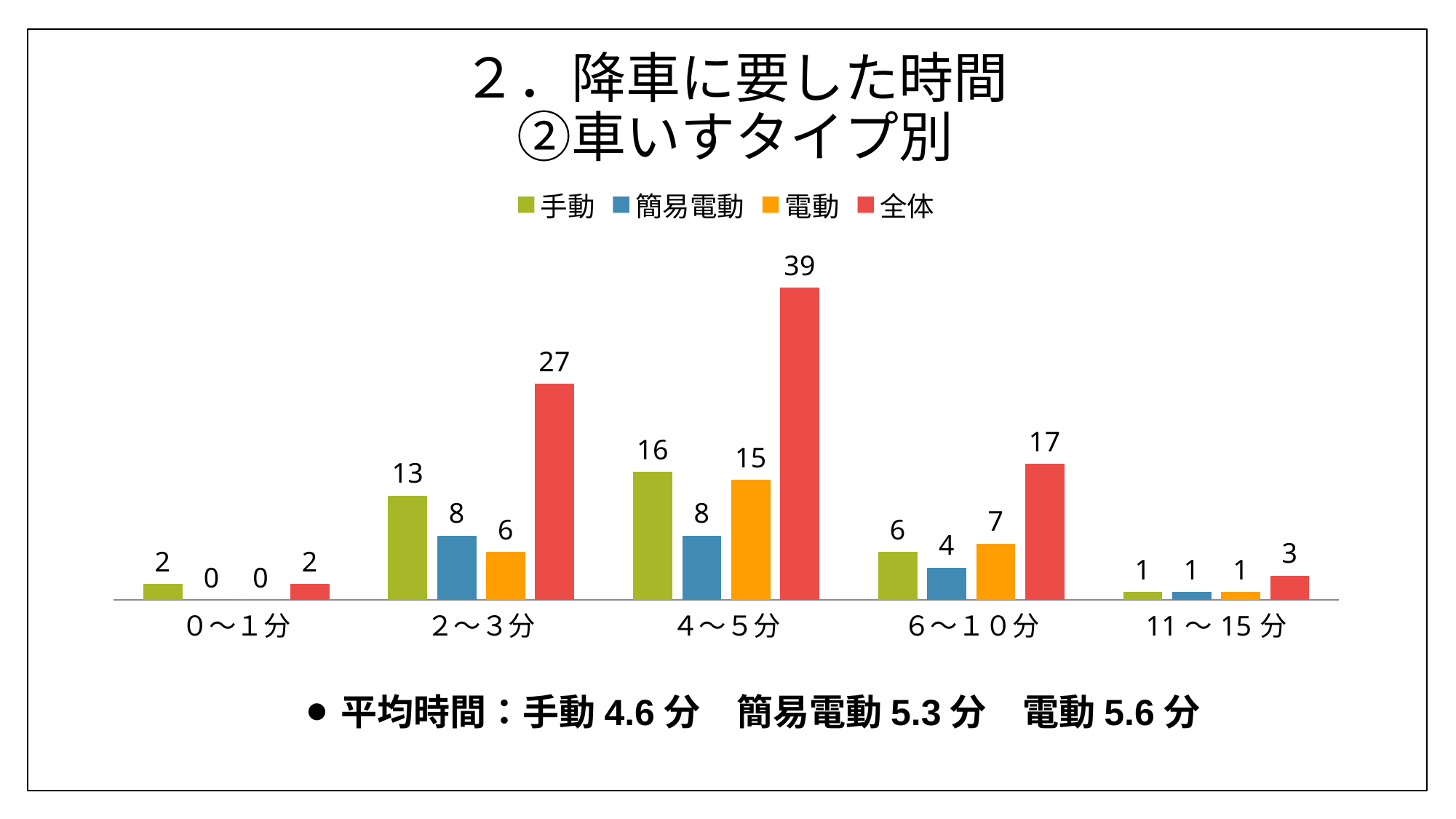
In which category is the 全体 series highest? 4～5分 What kind of chart is shown on the slide? bar chart What is the value for 手動 in the 2～3分 category? 13 In which category is the 手動 series lowest? 11～15分 Which is larger in the 4～5分 category: 手動 or 電動? 手動 What is the difference between 全体 in 4～5分 and 全体 in 2～3分? 12 What is the value for 電動 in the 6～10分 category? 7 What is the value for 全体 in the 4～5分 category? 39 Which series is shown in red in the legend? 全体 How many categories are shown on the x axis? 5 How many series does the legend list? 4 What is the value for 簡易電動 in the 0～1分 category? 0